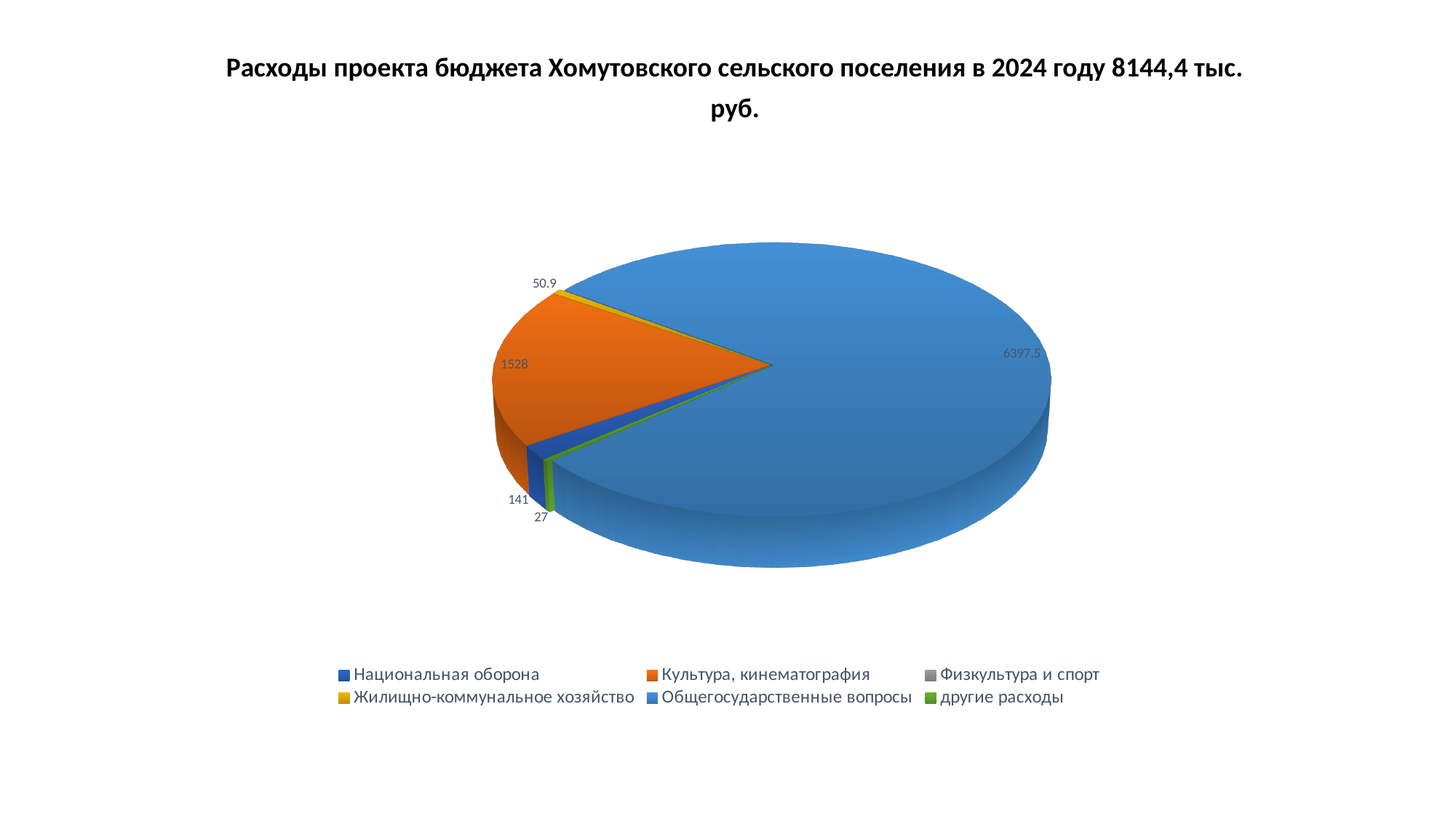
Which category has the largest slice of the pie? Общегосударственные вопросы Of the slices with data labels, which category has the smallest value? другие расходы How many entries does the legend list? 6 What is the value shown for Общегосударственные вопросы? 6397.5 What is the difference between the values for Общегосударственные вопросы and Культура, кинематография? 4869.5 What is the value shown for Жилищно-коммунальное хозяйство? 50.9 Which is larger, the value for Национальная оборона or the value for Жилищно-коммунальное хозяйство? Национальная оборона What is the value shown for Культура, кинематография? 1528 What is the value shown for Национальная оборона? 141 What type of chart is shown on the slide? pie chart What is the value shown for другие расходы? 27 What is the difference between the values for Национальная оборона and другие расходы? 114